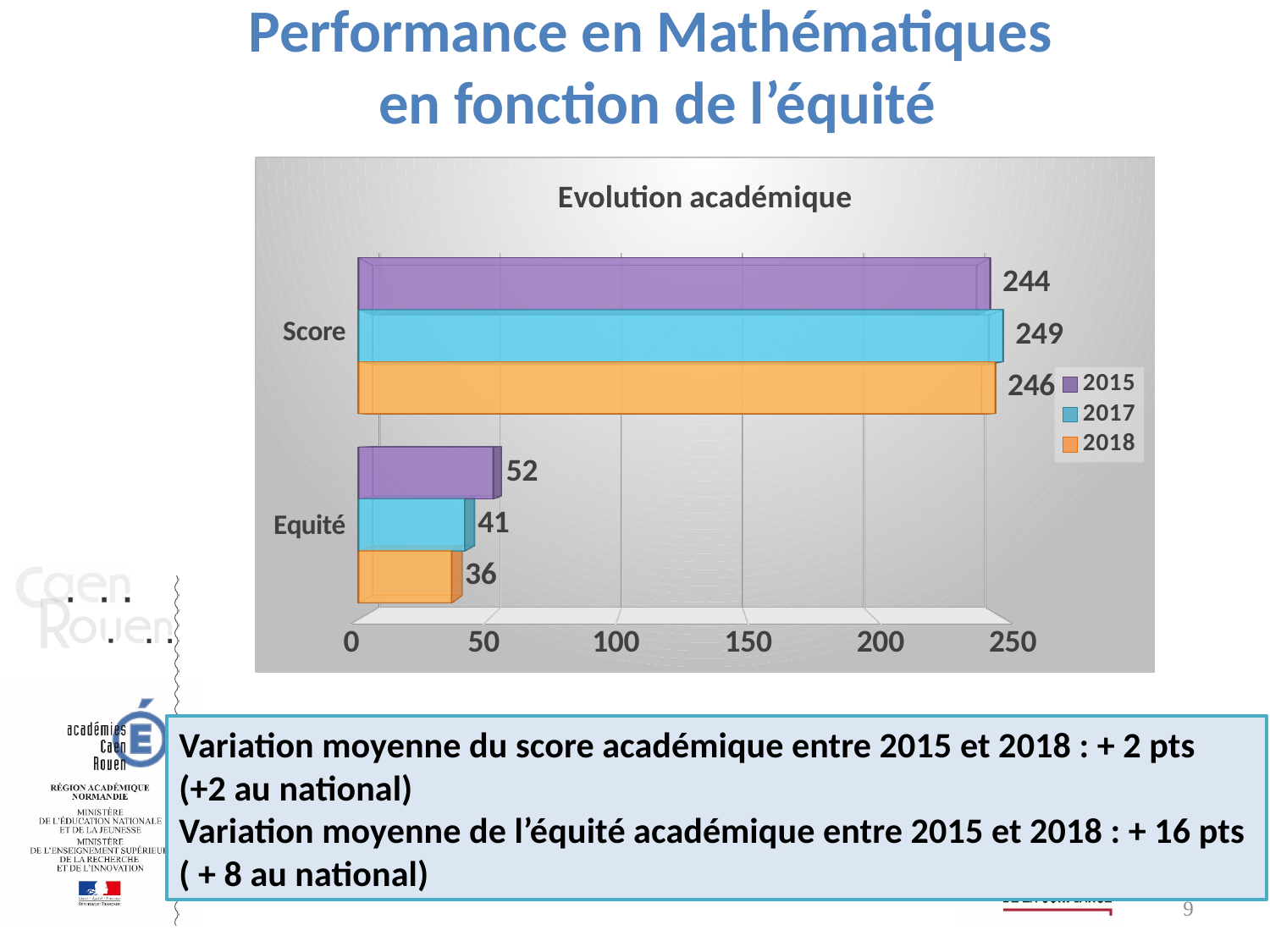
What is the title of the chart? Evolution académique Which is larger, the Equité value for 2017 or for 2018? 2017 What is the difference between the Equité values for 2015 and 2018? 16 What is the Score value for 2015? 244 What is the difference between the Score values for 2017 and 2015? 5 Which year has the highest Equité value? 2015 What kind of chart is shown on the slide? Bar chart How many series does the legend list? 3 Which year has the lowest Score value? 2015 What is the Score value for 2017? 249 What is the Equité value for 2018? 36 How many categories are shown on the chart? 2